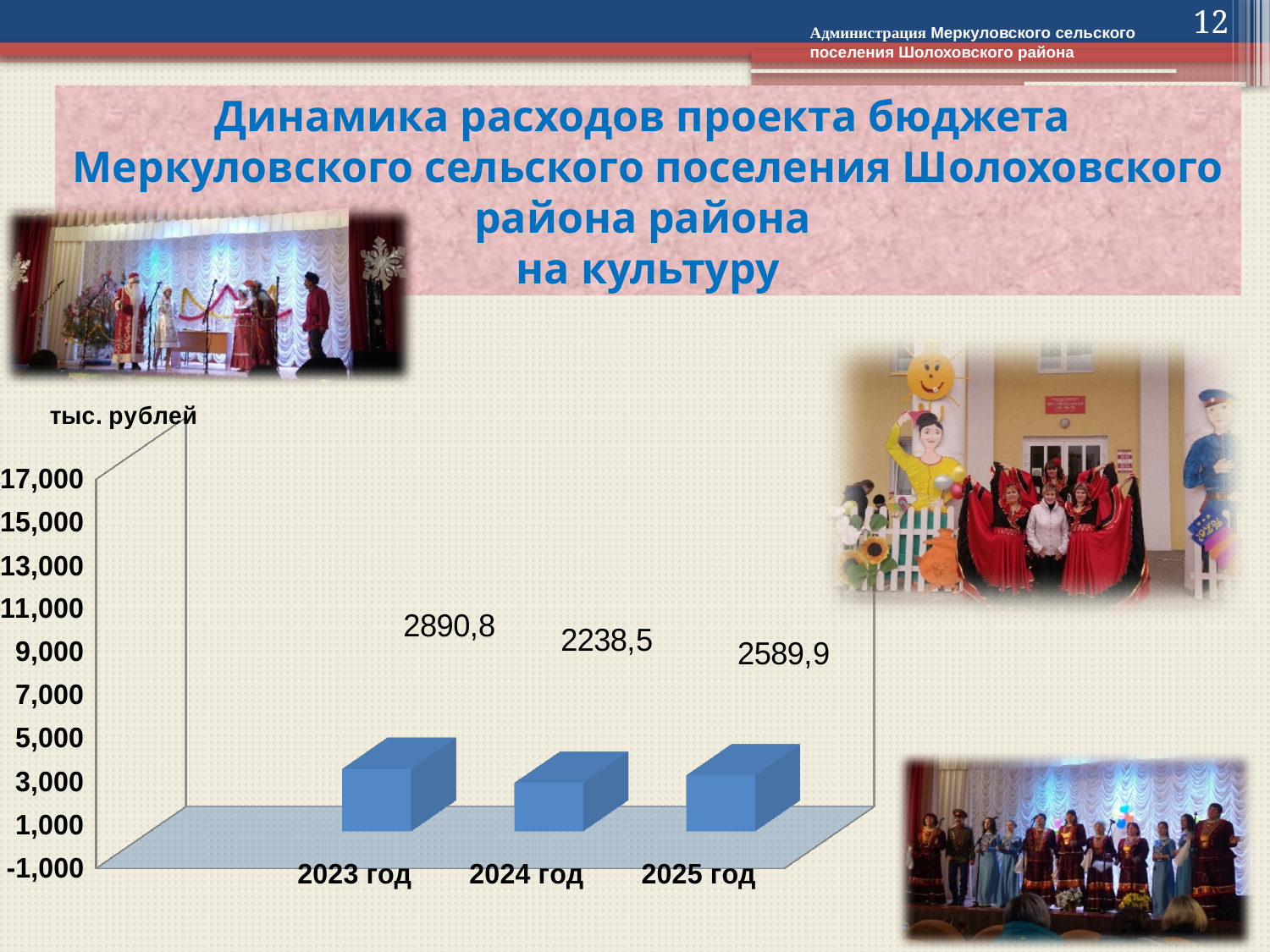
How many years are shown on the chart? 3 What is the difference between the values for 2023 год and 2024 год? 652,3 What unit is shown on the chart's vertical axis label? тыс. рублей What kind of chart is shown on the slide? bar chart Which year has the highest value? 2023 год Which year has the lowest value? 2024 год Is the value for 2023 год greater or less than 5,000? less Which is larger, the value for 2023 год or the value for 2025 год? 2023 год What is the value for 2023 год? 2890,8 What is the value for 2024 год? 2238,5 What is the value for 2025 год? 2589,9 What is the difference between the values for 2025 год and 2024 год? 351,4